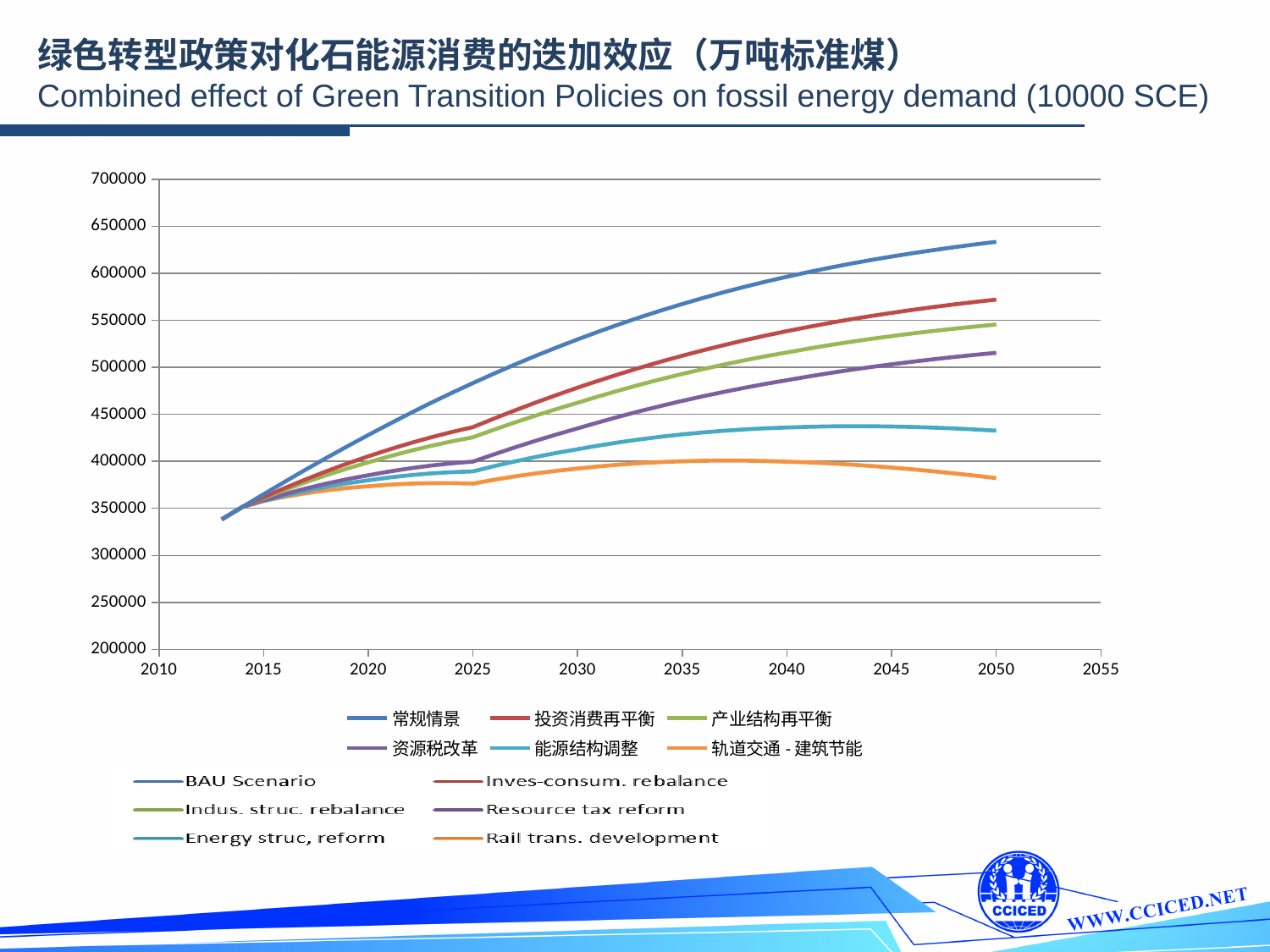
In 2050, which is larger: Inves-consum. rebalance or Resource tax reform? Inves-consum. rebalance Is the value for Indus. struc. rebalance in 2050 greater or less than 500000? greater Does the Rail trans. development line rise or fall between 2040 and 2050? falls Which series has the highest value in 2050? BAU Scenario Which series has the lowest value in 2050? Rail trans. development How many series does the chart's legend list? 6 What is the highest tick value shown on the vertical axis? 700000 Is the value for Rail trans. development in 2050 greater or less than 400000? less Is the value for Energy struc. reform in 2050 greater or less than 450000? less What kind of chart is shown on the slide? line chart Does the BAU Scenario line rise or fall from 2013 to 2050? rises